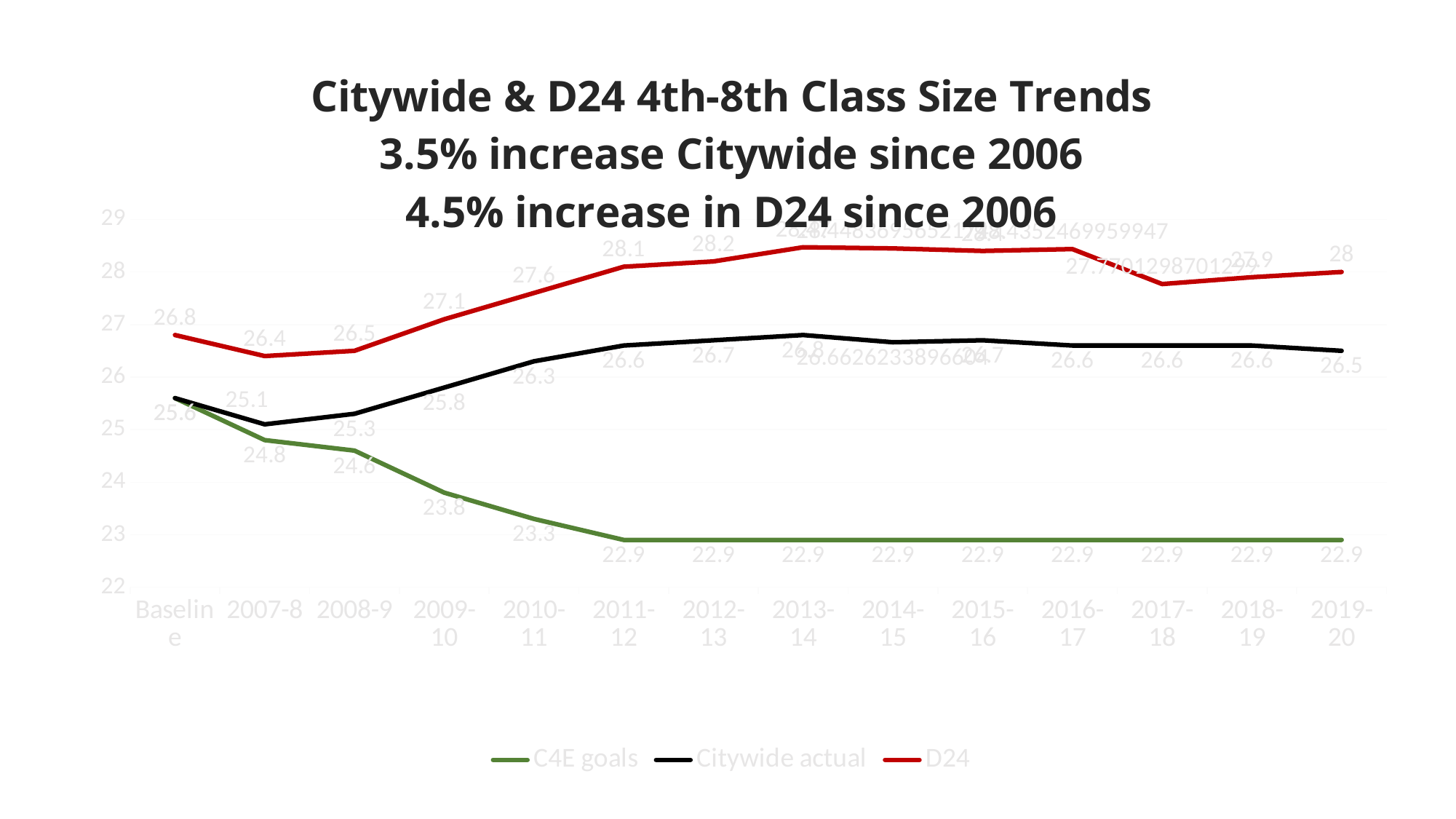
In which year is the Citywide actual value lowest? 2007-8 What is the difference between the D24 value and the Citywide actual value in 2012-13? 1.5 What kind of chart is shown on the slide? line chart How many series does the legend list? 3 Is the D24 value for 2013-14 greater or less than 28? greater What is the C4E goals value for 2019-20? 22.9 What colour is the D24 line? red Which is larger in 2019-20, the D24 value or the Citywide actual value? D24 Do the C4E goals values rise or fall from Baseline to 2011-12? fall How many categories are shown along the x axis? 14 What is the D24 value for 2011-12? 28.1 What is the Citywide actual value for 2010-11? 26.3